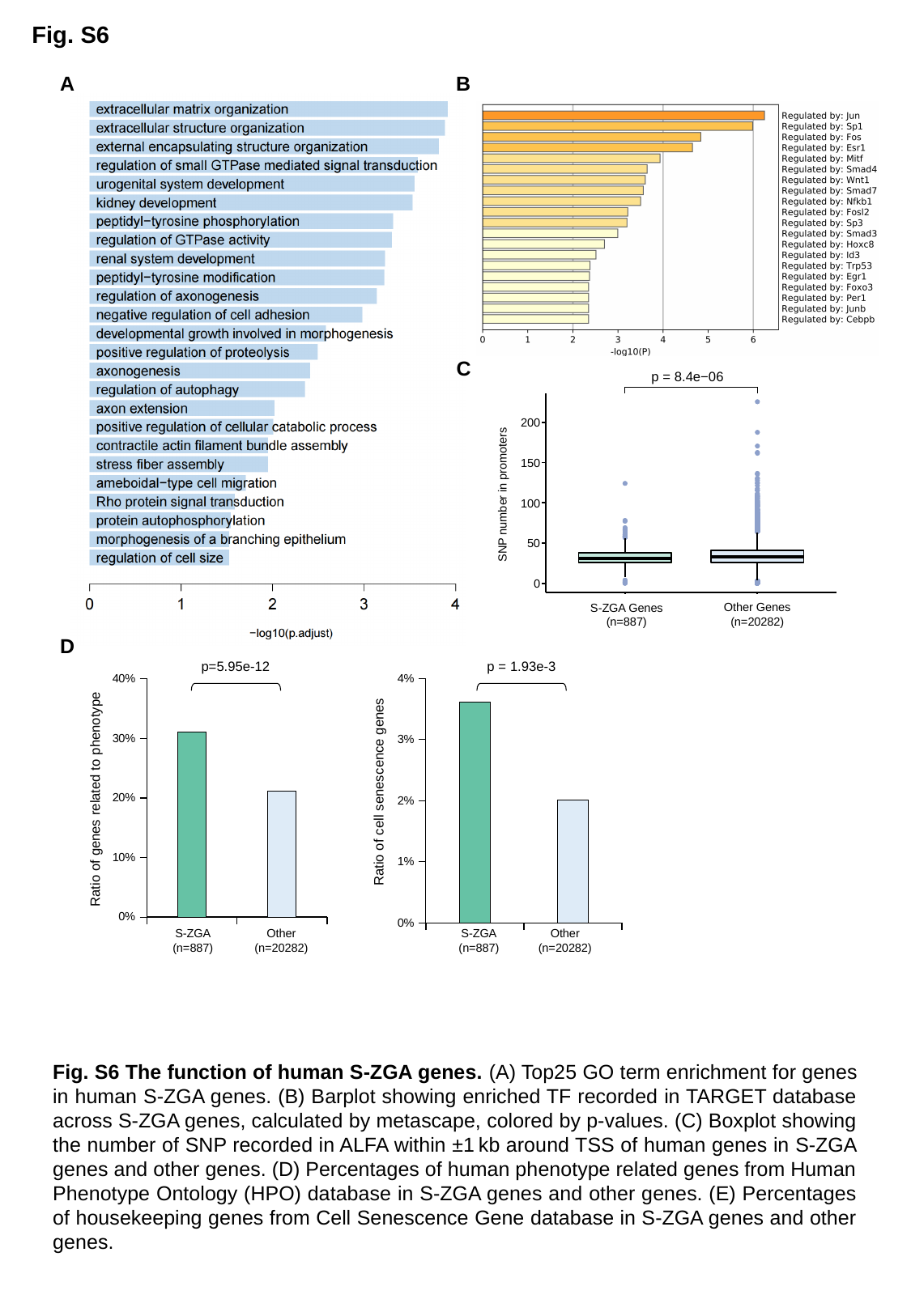
In panel B, is the value for Regulated by: Jun greater or less than 5? greater In panel B, which transcription factor has the highest −log10(P) value? Regulated by: Jun In panel A, which GO term has the lowest −log10(p.adjust) value? regulation of cell size In panel D, what p-value is printed above the left chart (Ratio of genes related to phenotype)? p=5.95e-12 In panel A, which GO term has the highest −log10(p.adjust) value? extracellular matrix organization In panel C, what p-value is shown above the boxplot? p = 8.4e−06 In panel A, is the value for regulation of cell size greater or less than 2? less In panel B, how many transcription factors are plotted? 20 In panel B, which transcription factor has the lowest −log10(P) value? Regulated by: Cebpb In panel D, the right chart (Ratio of cell senescence genes), is the value for S-ZGA greater or less than 3%? greater In panel A, how many GO terms are plotted? 25 In panel D, the left chart (Ratio of genes related to phenotype), which group has the larger value, S-ZGA or Other? S-ZGA